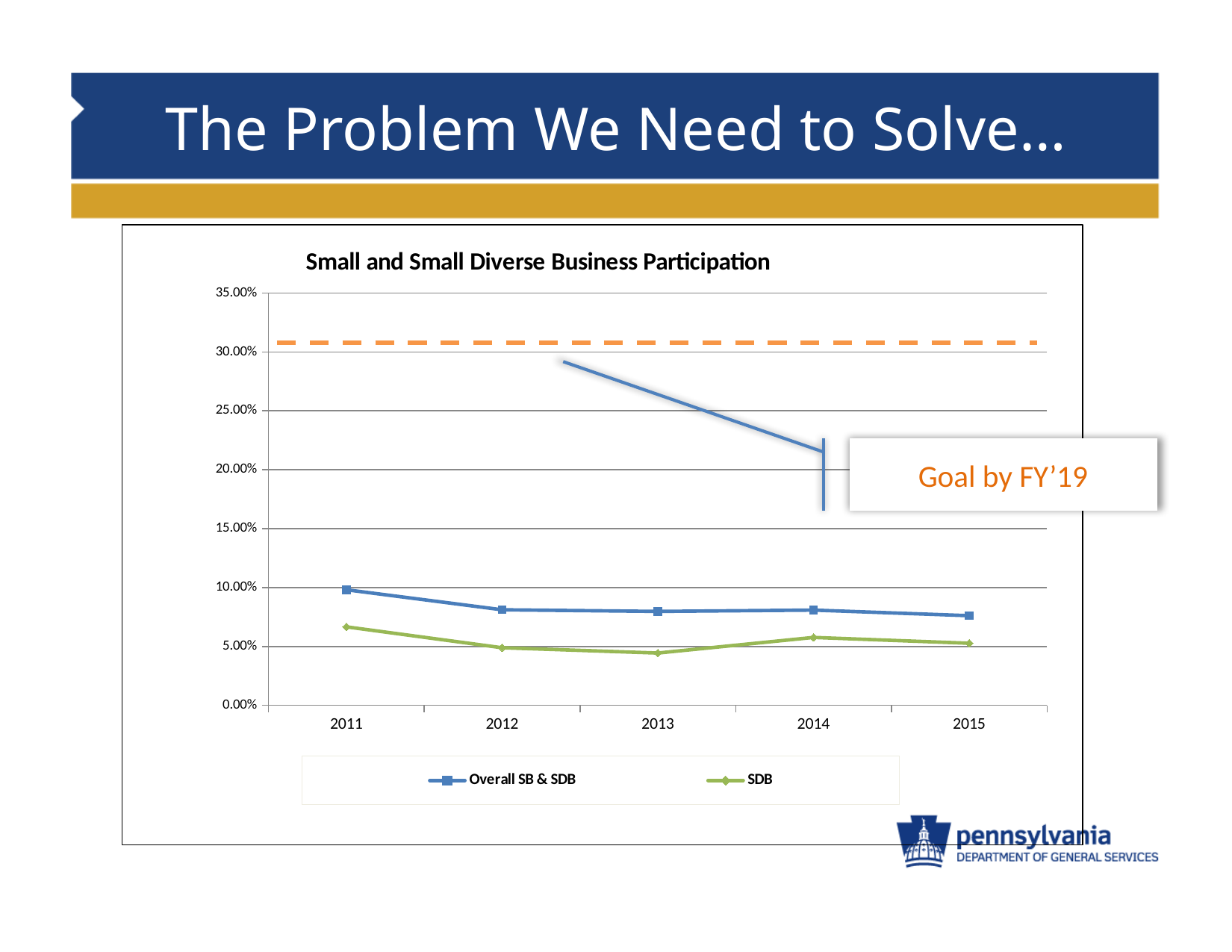
How many series does the legend list? 2 What kind of chart is shown on the slide? line chart What does the orange dashed line near 30% represent, according to the callout? Goal by FY'19 Which is larger for Overall SB & SDB, the value in 2011 or the value in 2015? 2011 What is the title of the chart? Small and Small Diverse Business Participation Is the SDB value for 2011 greater or less than 5.00%? greater In which year is the SDB series at its highest? 2011 Is the Overall SB & SDB value for 2015 greater or less than 10.00%? less In which year is the SDB series at its lowest? 2013 In which year is the Overall SB & SDB series at its highest? 2011 Is the SDB value for 2013 greater or less than 5.00%? less How many years are plotted along the x axis? 5